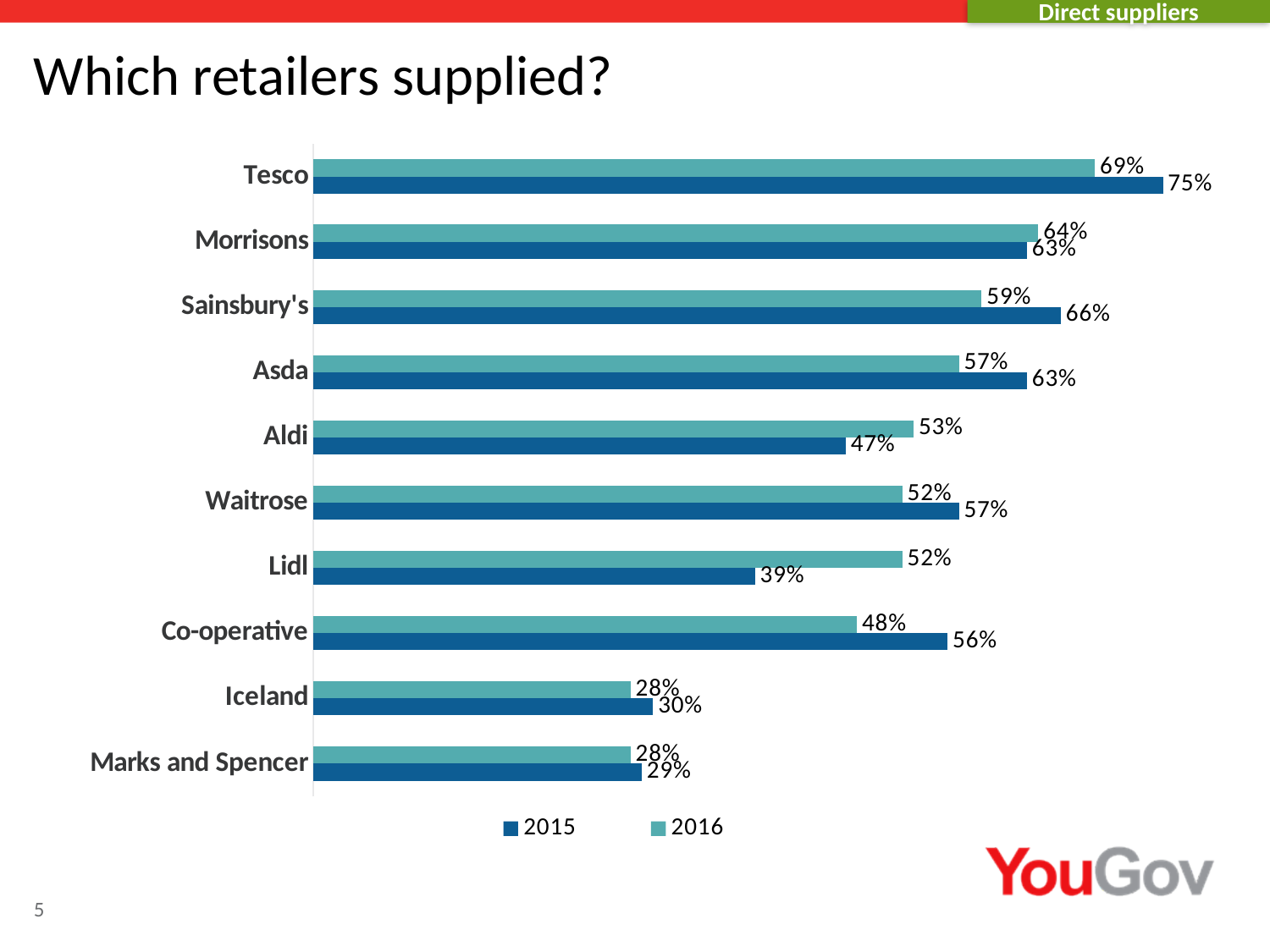
What is the title of the slide? Which retailers supplied? Which retailer had the highest value in 2016? Tesco What was the value for Co-operative in 2015? 56% Which retailer had the lowest value in 2015? Marks and Spencer How many retailers are shown in the chart? 10 Which is larger for Aldi: the 2015 value or the 2016 value? 2016 What is the difference between Lidl's 2016 and 2015 values? 13 percentage points What kind of chart is shown on the slide? Bar chart How many series does the legend list? 2 What is the difference between Tesco's 2015 and 2016 values? 6 percentage points What was the value for Lidl in 2016? 52% What was the value for Tesco in 2015? 75%